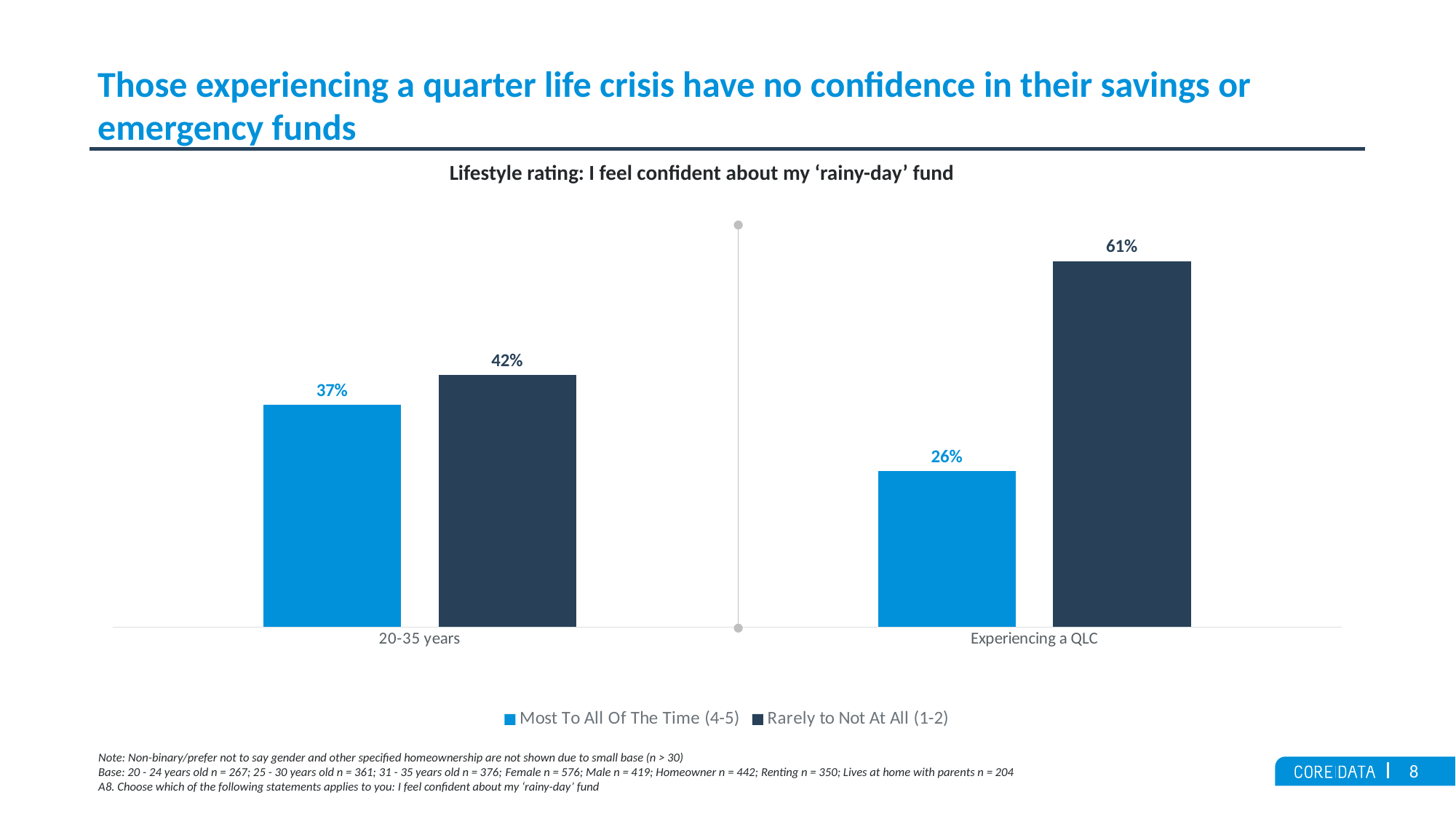
What type of chart is shown on the slide? Bar chart Which is larger in the Experiencing a QLC category: 'Most To All Of The Time (4-5)' or 'Rarely to Not At All (1-2)'? Rarely to Not At All (1-2) How many categories are shown on the x axis? 2 What is the value for 'Most To All Of The Time (4-5)' in the Experiencing a QLC category? 26% Which bar has the lowest value on the chart? Most To All Of The Time (4-5), Experiencing a QLC What is the value for 'Most To All Of The Time (4-5)' in the 20-35 years category? 37% How many series does the legend list? 2 Which bar has the highest value on the chart? Rarely to Not At All (1-2), Experiencing a QLC What is the difference between the 'Most To All Of The Time (4-5)' and 'Rarely to Not At All (1-2)' values in the 20-35 years category? 5% What is the difference between the 'Rarely to Not At All (1-2)' values for Experiencing a QLC and 20-35 years? 19% What is the value for 'Rarely to Not At All (1-2)' in the 20-35 years category? 42% What is the value for 'Rarely to Not At All (1-2)' in the Experiencing a QLC category? 61%